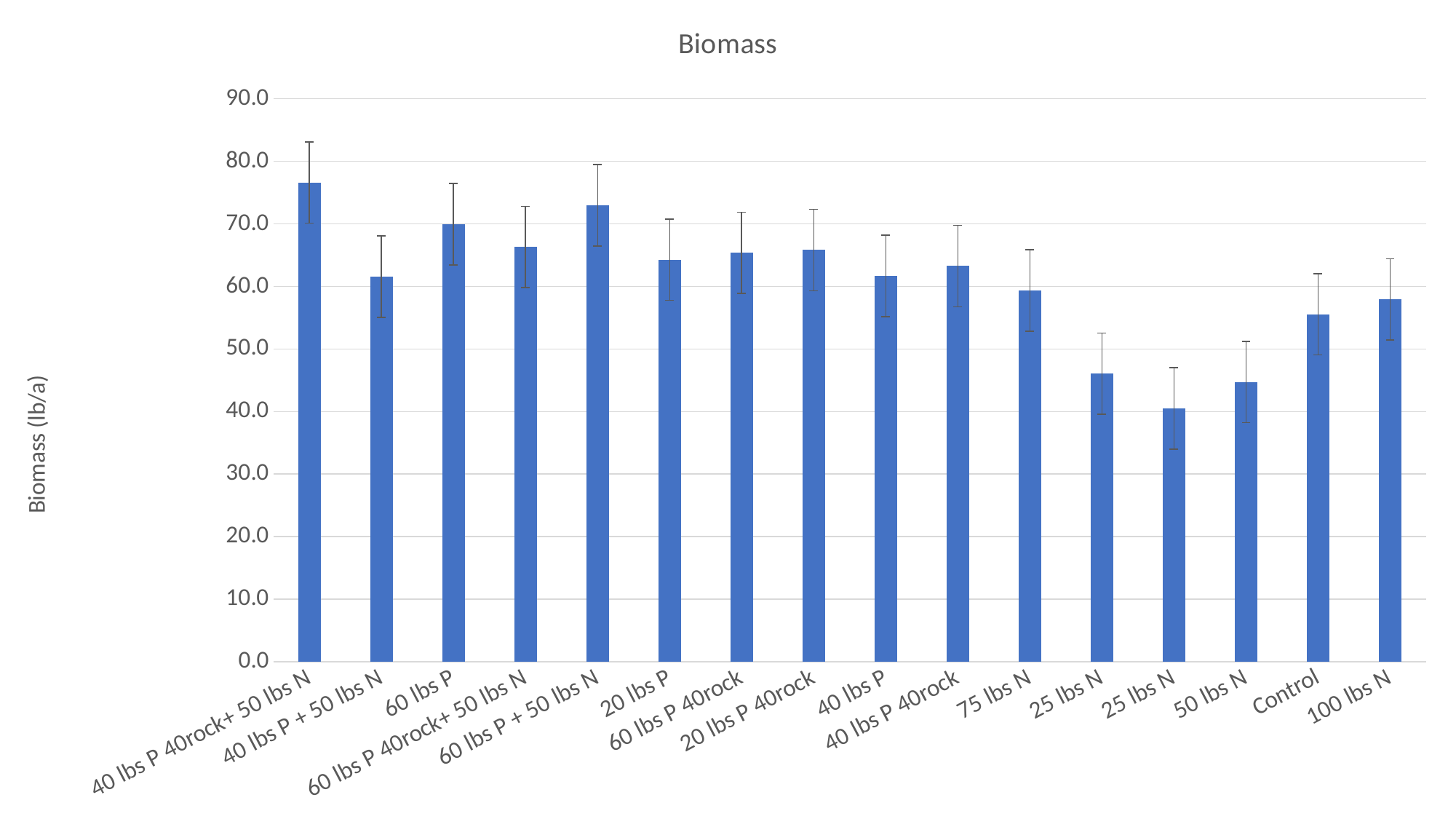
What is the label on the vertical axis of the chart? Biomass (lb/a) Which treatment has the highest biomass? 40 lbs P 40rock+ 50 lbs N Which treatment has the lowest biomass? 25 lbs N Is the value for 60 lbs P greater or less than 60? greater What is the title of the chart? Biomass What kind of chart is shown on the slide? bar chart Is the value for 50 lbs N greater or less than 50? less Is the value for 100 lbs N greater or less than 60? less Which has the larger biomass, 60 lbs P or 20 lbs P? 60 lbs P Which has the larger biomass, Control or 50 lbs N? Control How many bars (treatment categories) are plotted in the chart? 16